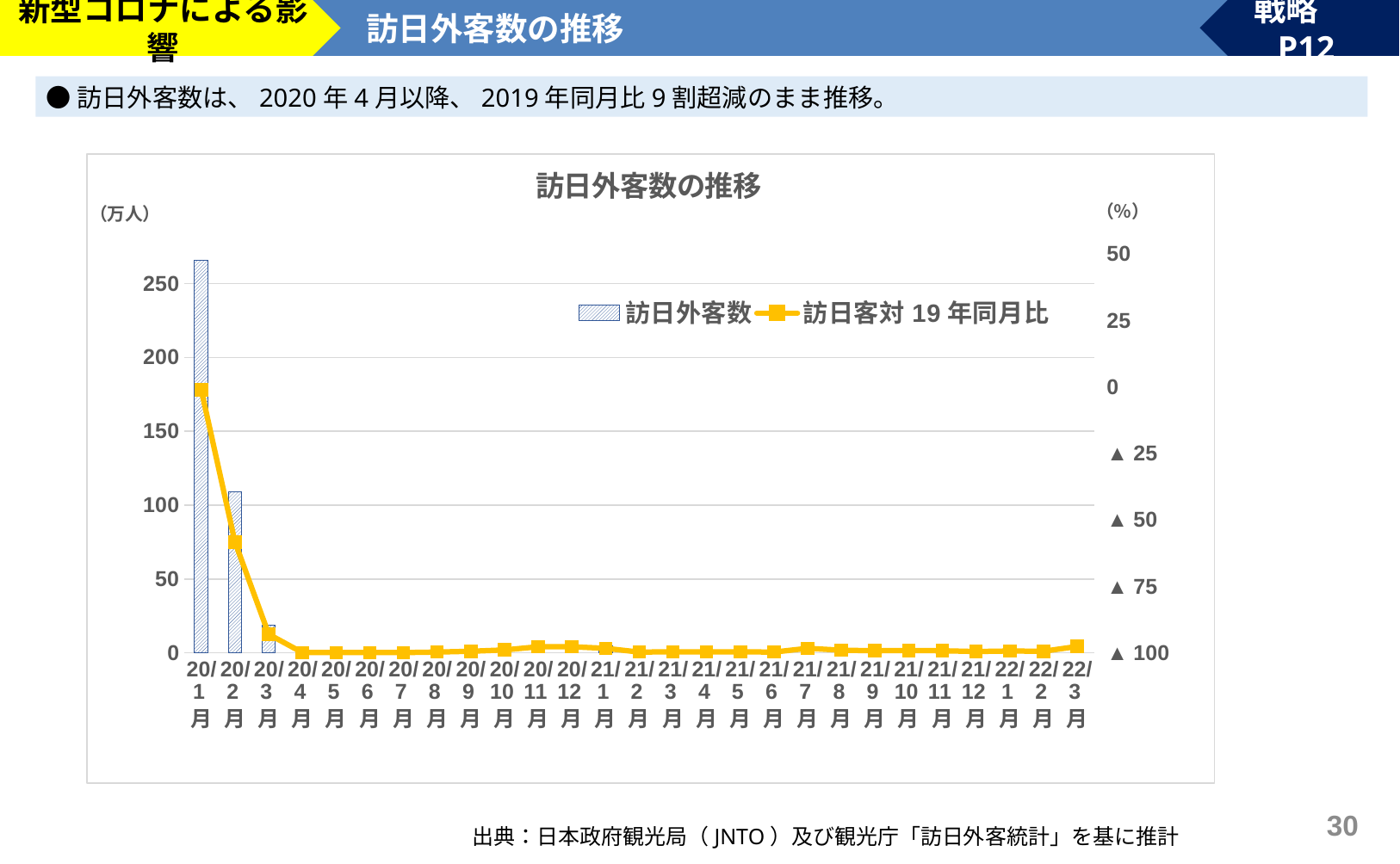
Is the 訪日外客数 bar for 20/1月 greater or less than 250? greater What unit is shown on the left vertical axis? 万人 What are the two series named in the legend? 訪日外客数 and 訪日客対19年同月比 Is the 訪日外客数 bar for 20/2月 greater or less than 150? less How many months (categories) are shown on the x axis? 27 Which is larger, the 訪日外客数 bar for 20/1月 or for 20/2月? 20/1月 What kind of chart is shown on the slide? A combined bar and line chart Does the 訪日客対19年同月比 line rise or fall from 20/1月 to 20/4月? It falls Is the 訪日外客数 bar for 20/3月 greater or less than 50? less Which month has the highest bar for 訪日外客数? 20/1月 How many series does the legend list? 2